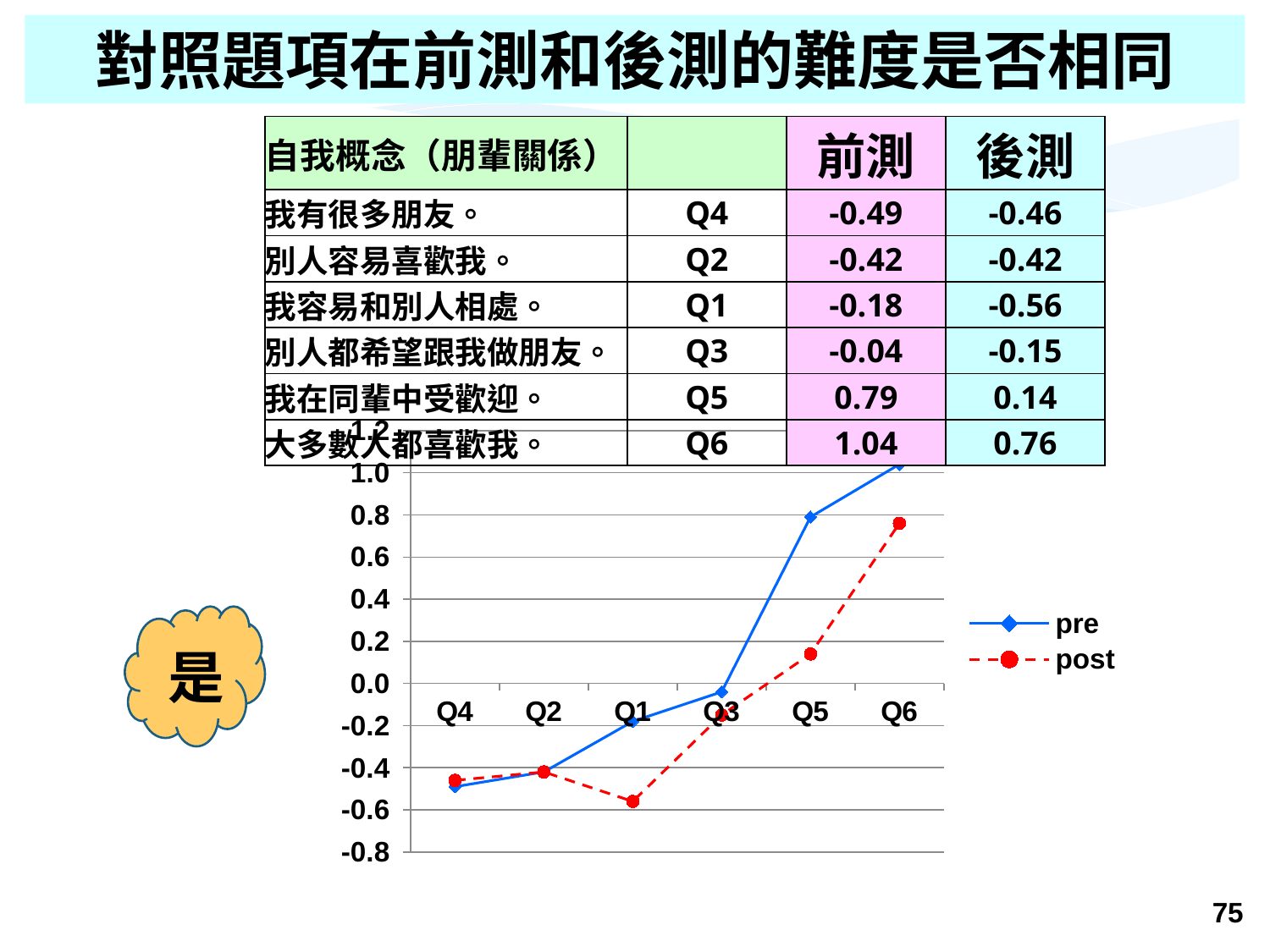
How many categories are plotted along the x axis of the chart? 6 How many series does the chart legend list? 2 According to the slide, what is the post (後測) value for Q1? -0.56 For Q5, which series has the larger value, pre or post? pre What are the two series named in the chart legend? pre and post Which category has the highest pre value in the chart? Q6 Which category has the lowest post value in the chart? Q1 What kind of chart is shown on the slide? line chart Is the post value for Q3 greater or less than 0.0? less Do the pre values generally rise or fall from Q4 to Q6 along the x axis? rise According to the slide, what is the pre (前測) value for Q5? 0.79 Is the pre value for Q5 greater or less than 0.6? greater